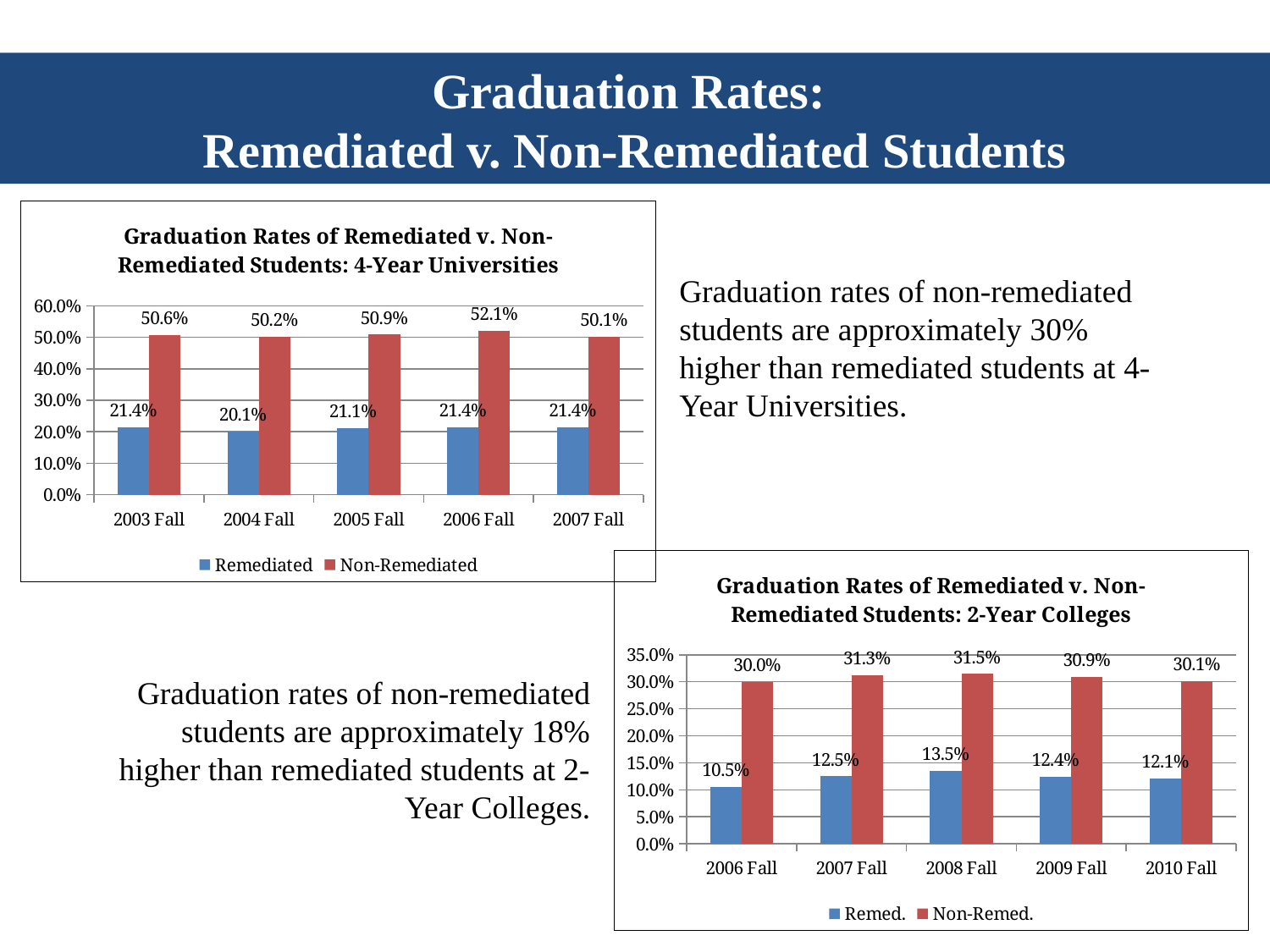
In the 4-Year Universities chart, what is the graduation rate for Remediated students in 2004 Fall? 20.1% In the 2-Year Colleges chart, what is the graduation rate for Non-Remed. students in 2010 Fall? 30.1% What kind of chart is the 2-Year Colleges chart? Bar chart In the 4-Year Universities chart, what is the graduation rate for Non-Remediated students in 2006 Fall? 52.1% In the 4-Year Universities chart, how many years are shown on the x axis? 5 In the 2-Year Colleges chart, what is the difference between the Non-Remed. and Remed. rates in 2006 Fall? 19.5% In the 4-Year Universities chart, which year has the highest Non-Remediated graduation rate? 2006 Fall In the 2-Year Colleges chart, which year has the highest Non-Remed. graduation rate? 2008 Fall In the 2-Year Colleges chart, what is the graduation rate for Remed. students in 2008 Fall? 13.5% In the 2-Year Colleges chart, which year has the lowest Remed. graduation rate? 2006 Fall In the 4-Year Universities chart, which year has the lowest Remediated graduation rate? 2004 Fall In the 4-Year Universities chart, what is the difference between the Non-Remediated and Remediated rates in 2003 Fall? 29.2%